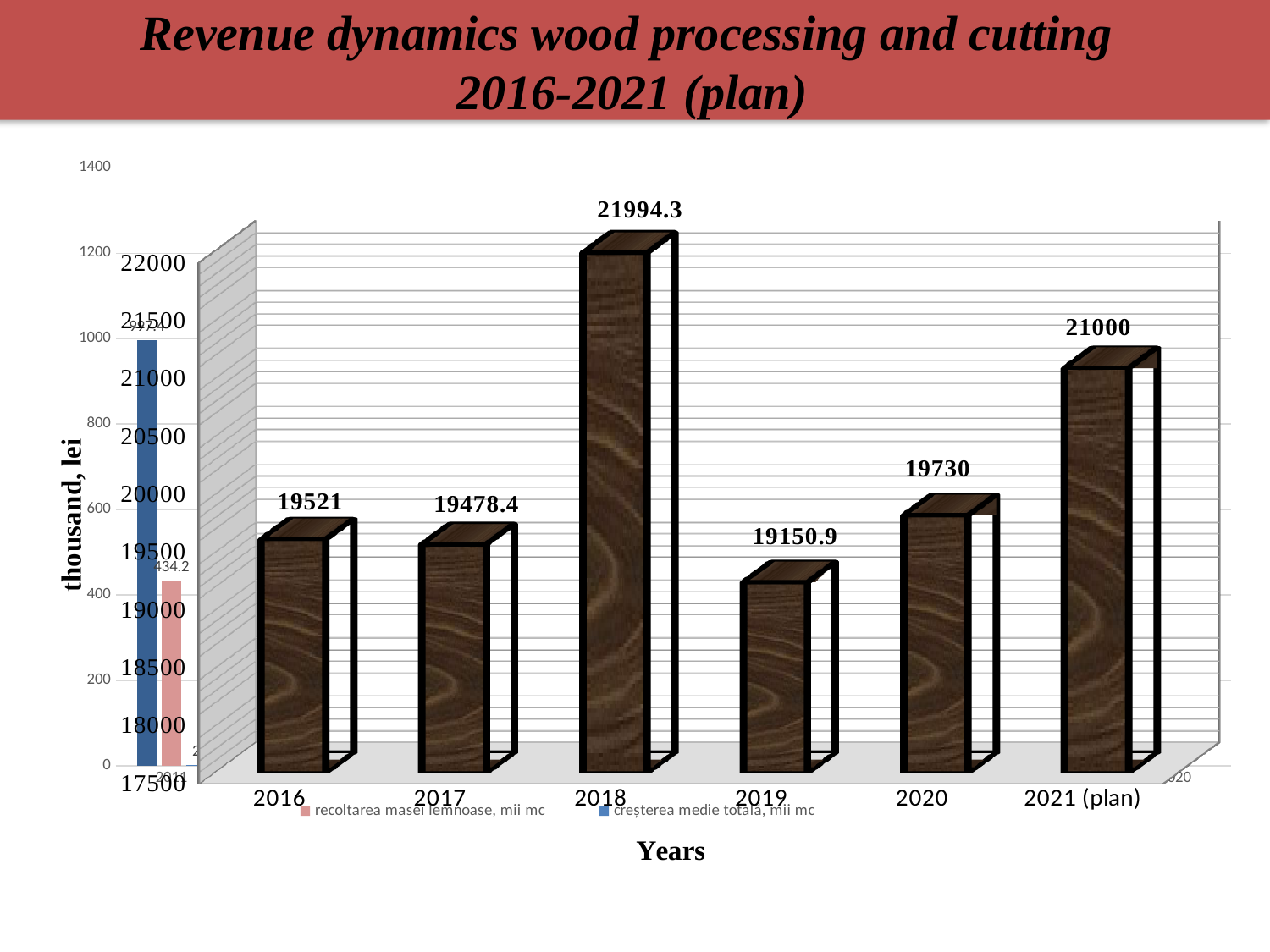
What kind of chart is the main revenue chart? bar chart In the main revenue chart, how much higher is the 2020 value than the 2016 value? 209 In the main revenue chart, what is the value for 2018? 21994.3 What is the y-axis title of the main revenue chart? thousand, lei In the main revenue chart, which year has the highest value? 2018 In the main revenue chart, which year has the lowest value? 2019 In the main revenue chart, which is larger, the value for 2016 or the value for 2017? 2016 How many years are shown on the x axis of the main revenue chart? 6 In the main revenue chart, what is the value for 2019? 19150.9 In the main revenue chart, what is the planned value for 2021? 21000 In the main revenue chart, what is the difference between the 2018 value and the 2019 value? 2843.4 In the main revenue chart, do the values rise or fall from 2019 to 2021 (plan)? rise